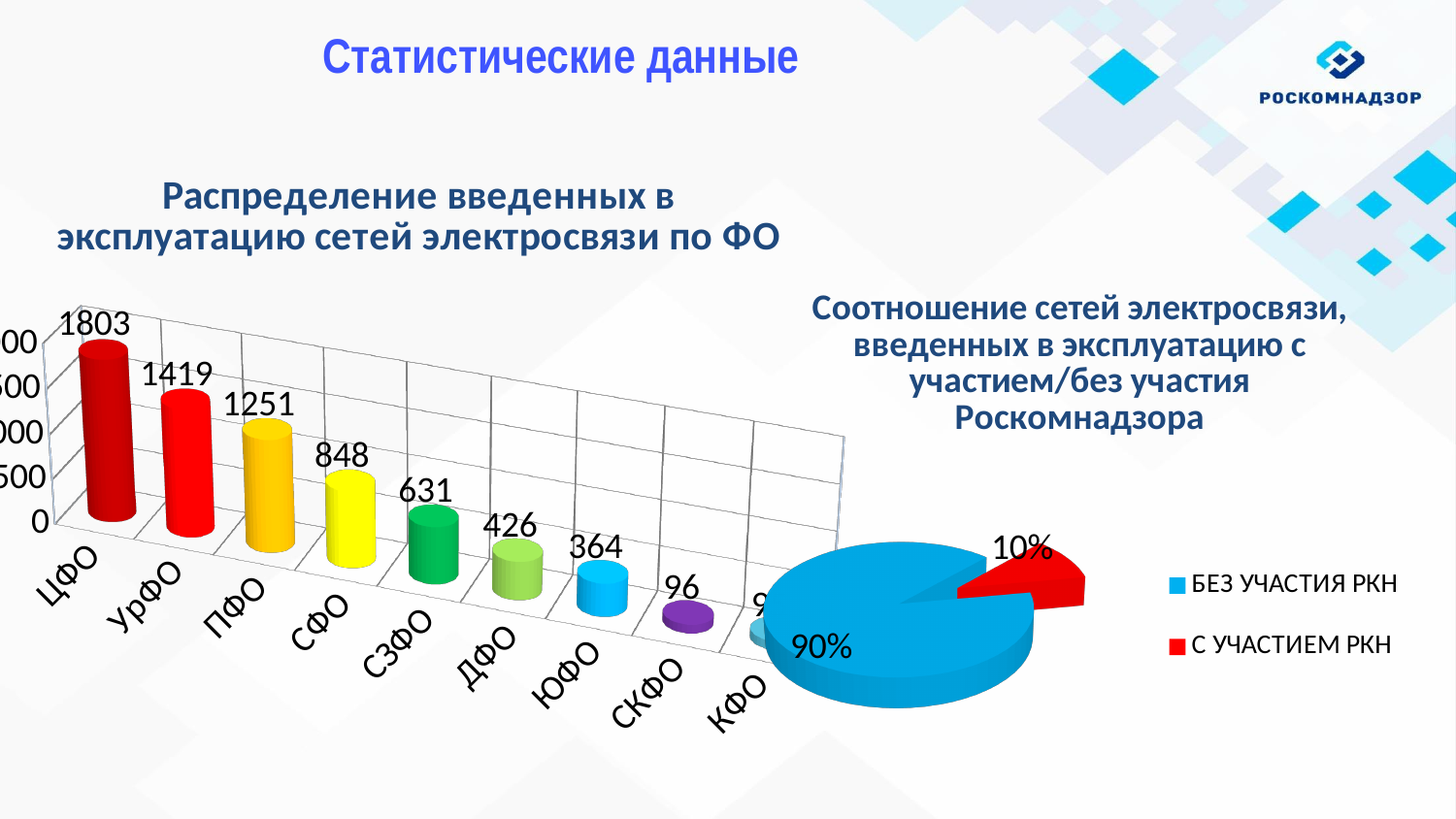
In the bar chart 'Распределение введенных в эксплуатацию сетей электросвязи по ФО', what is the value for ЦФО? 1803 In the bar chart 'Распределение введенных в эксплуатацию сетей электросвязи по ФО', do the values rise or fall from left to right along the x axis? fall In the bar chart 'Распределение введенных в эксплуатацию сетей электросвязи по ФО', what is the value for ПФО? 1251 In the bar chart 'Распределение введенных в эксплуатацию сетей электросвязи по ФО', what is the value for ЮФО? 364 In the pie chart 'Соотношение сетей электросвязи, введенных в эксплуатацию с участием/без участия Роскомнадзора', what colour is the 'С УЧАСТИЕМ РКН' slice? red In the bar chart 'Распределение введенных в эксплуатацию сетей электросвязи по ФО', what is the difference between the values for УрФО and СФО? 571 In the bar chart 'Распределение введенных в эксплуатацию сетей электросвязи по ФО', which is larger, the value for СЗФО or the value for ДФО? СЗФО In the bar chart 'Распределение введенных в эксплуатацию сетей электросвязи по ФО', which federal district has the highest value? ЦФО In the pie chart 'Соотношение сетей электросвязи, введенных в эксплуатацию с участием/без участия Роскомнадзора', what share is 'БЕЗ УЧАСТИЯ РКН'? 90% In the bar chart 'Распределение введенных в эксплуатацию сетей электросвязи по ФО', is the value for СКФО greater or less than 500? less How many federal districts (categories) are shown in the bar chart 'Распределение введенных в эксплуатацию сетей электросвязи по ФО'? 9 What kind of chart is 'Распределение введенных в эксплуатацию сетей электросвязи по ФО'? bar chart